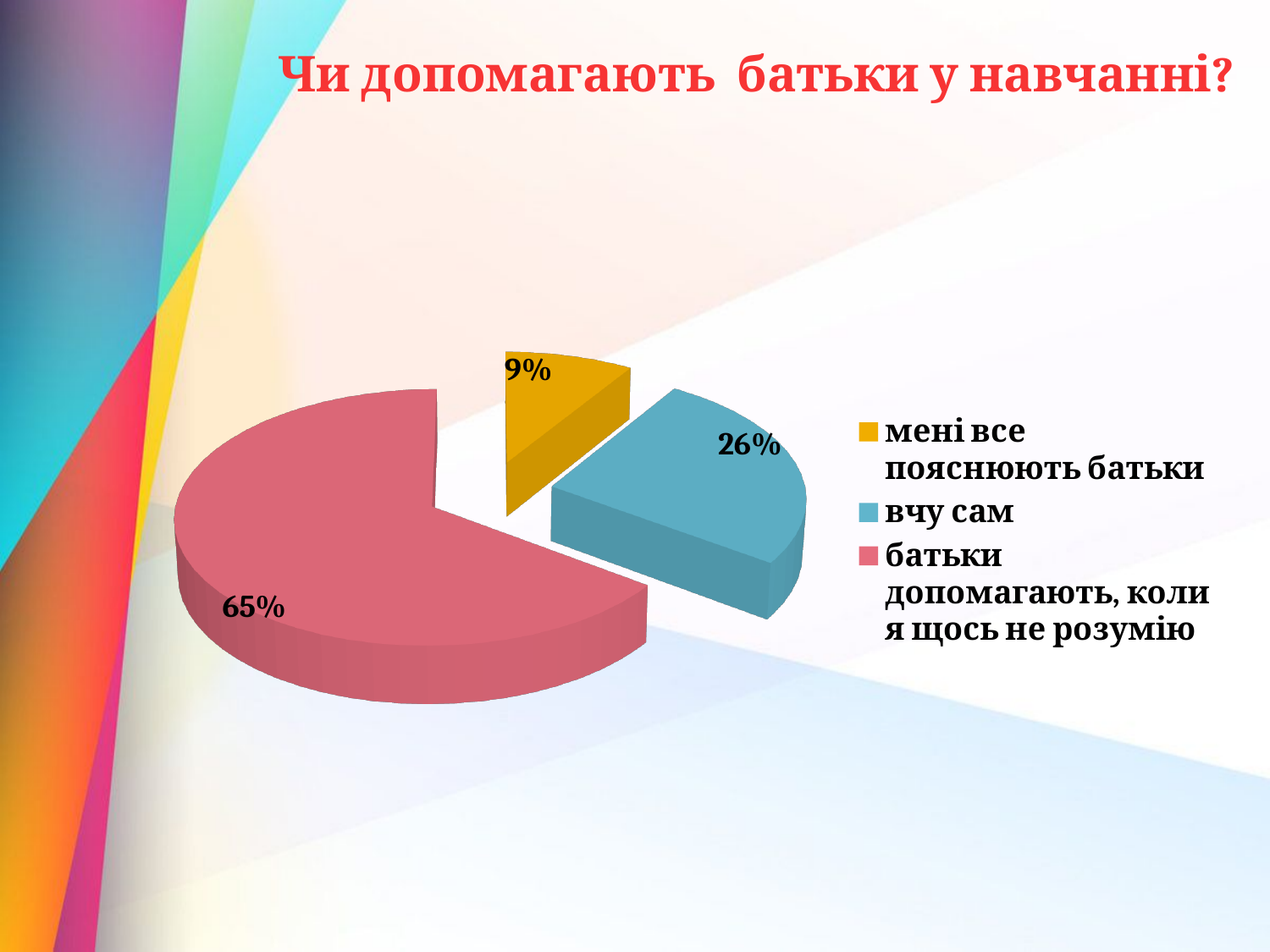
Which category has the smallest share of the pie? мені все пояснюють батьки What percentage of the pie is labelled "мені все пояснюють батьки"? 9% What is the difference between the shares for "батьки допомагають, коли я щось не розумію" and "вчу сам"? 39% What kind of chart is shown on the slide? pie chart What is the difference between the shares for "вчу сам" and "мені все пояснюють батьки"? 17% What percentage of the pie is labelled "батьки допомагають, коли я щось не розумію"? 65% Which category has the largest share of the pie? батьки допомагають, коли я щось не розумію What percentage of the pie is labelled "вчу сам"? 26% What colour is the slice for "вчу сам"? blue What is the title of the chart on the slide? Чи допомагають батьки у навчанні? How many categories does the legend list? 3 Which is larger: the share for "вчу сам" or the share for "мені все пояснюють батьки"? вчу сам